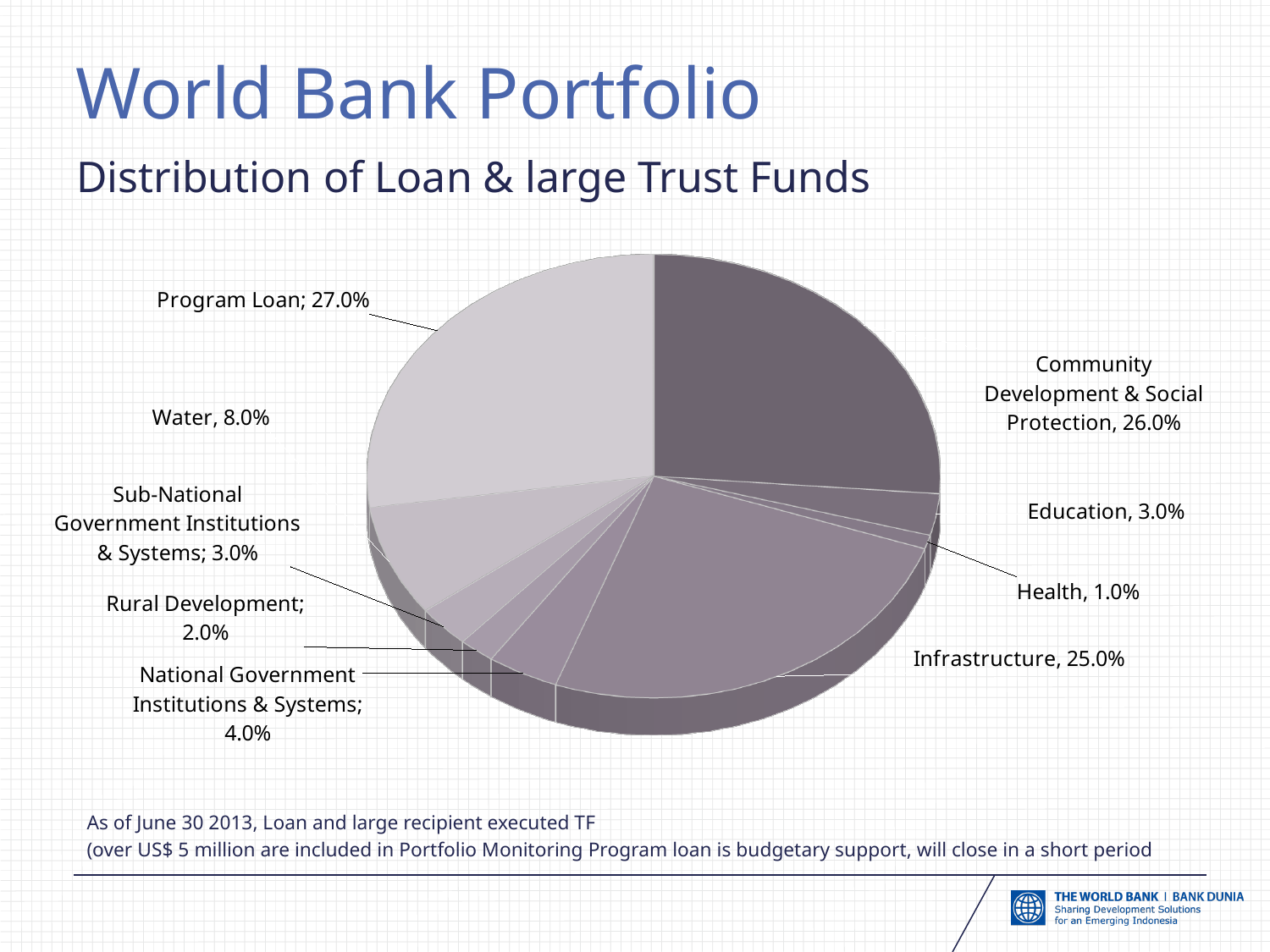
How many categories are shown in the pie chart? 9 What is the difference between the shares for Program Loan and Infrastructure? 2.0% What is the value for Community Development & Social Protection? 26.0% What kind of chart is shown on the slide? Pie chart Which is larger, the share for Water or the share for Rural Development? Water What is the value for Infrastructure? 25.0% What is the value for Water? 8.0% What is the subtitle of the chart on the slide? Distribution of Loan & large Trust Funds What is the value for National Government Institutions & Systems? 4.0% Which category has the smallest share of the pie? Health What share of the pie does Program Loan represent? 27.0% Which category has the largest share of the pie? Program Loan